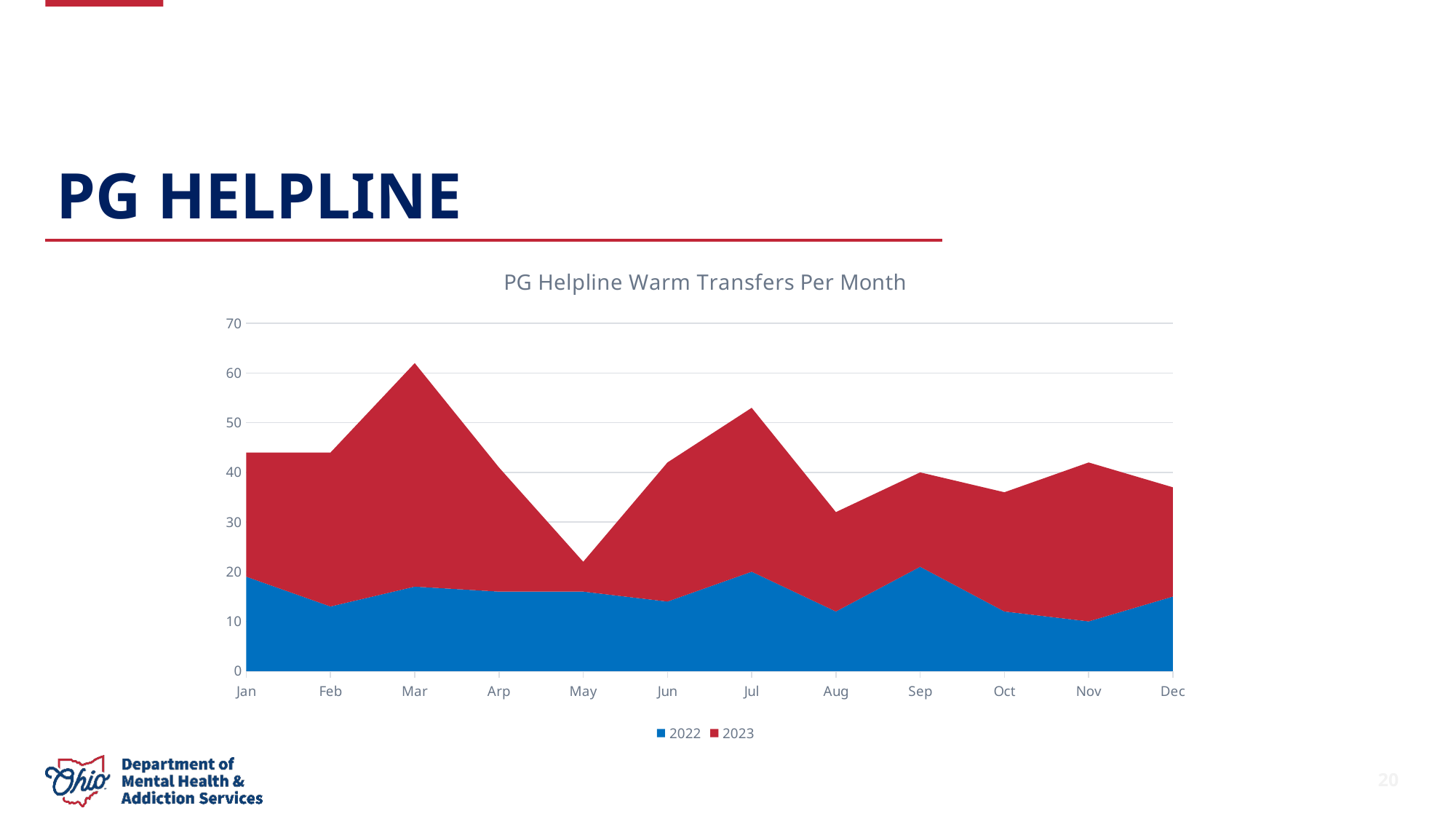
What is the title of the chart? PG Helpline Warm Transfers Per Month What type of chart is shown on the slide? Area chart Is the stacked total for May greater or less than 30? less Is the value for 2022 in Feb greater or less than 20? less How many series does the legend list? 2 How many months are shown along the x axis? 12 In which month does the stacked total of 2022 and 2023 reach its highest point? Mar Is the stacked total for Jul greater or less than 40? greater Does the stacked total rise or fall from Mar to May? fall Which colour represents the 2023 series? Red In which month is the stacked total of 2022 and 2023 lowest? May